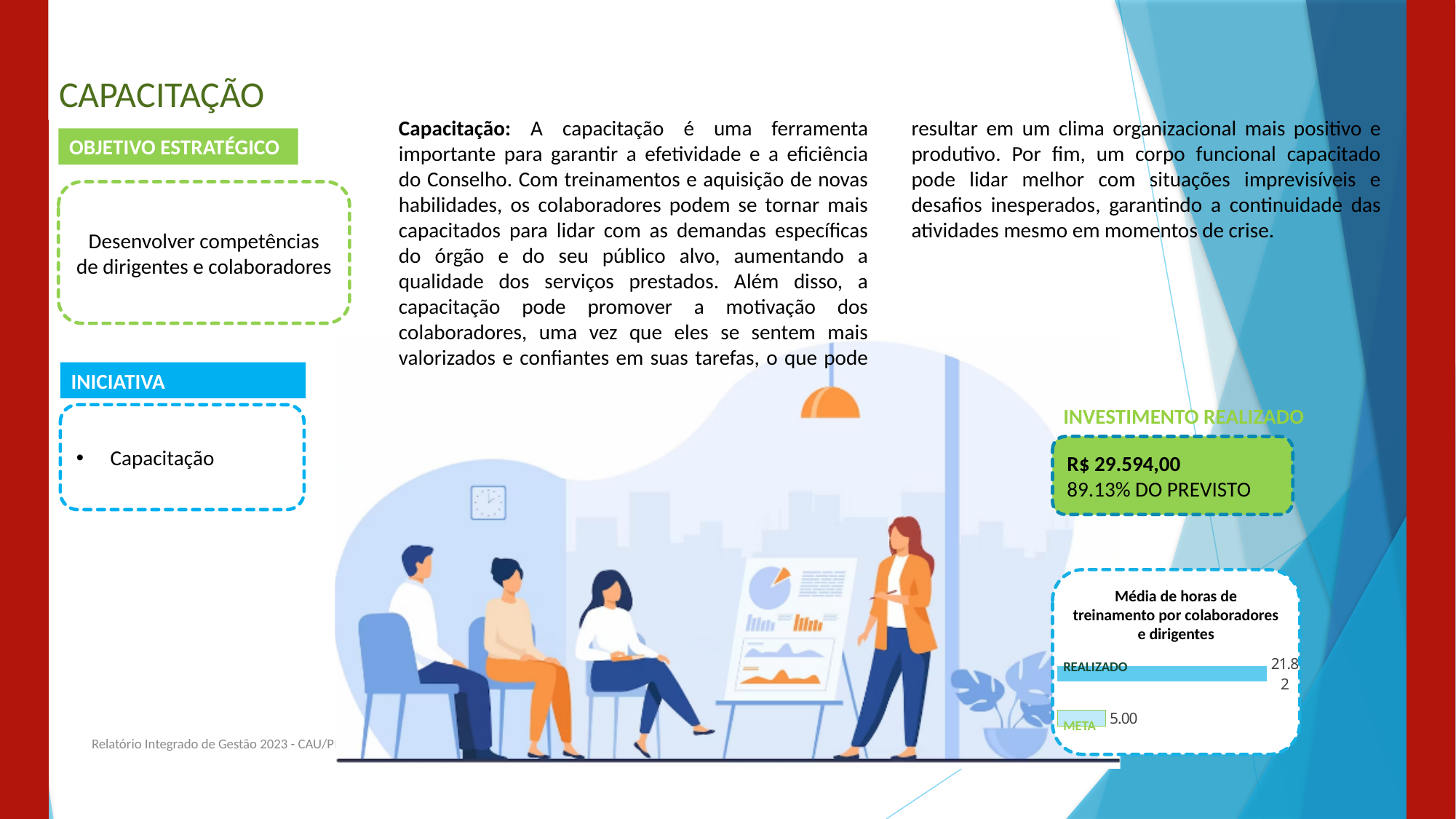
What is the title of the chart on the slide? Média de horas de treinamento por colaboradores e dirigentes What is the value for REALIZADO in the chart? 21.82 Which category has the lowest value in the chart? META Which is larger in the chart, REALIZADO or META? REALIZADO What is the difference between the REALIZADO and META values in the chart? 16.82 What is the value for META in the chart? 5.00 Which category has the highest value in the chart? REALIZADO How many bars does the chart show? 2 What are the two category labels shown on the chart? REALIZADO and META What kind of chart is shown on the slide? bar chart